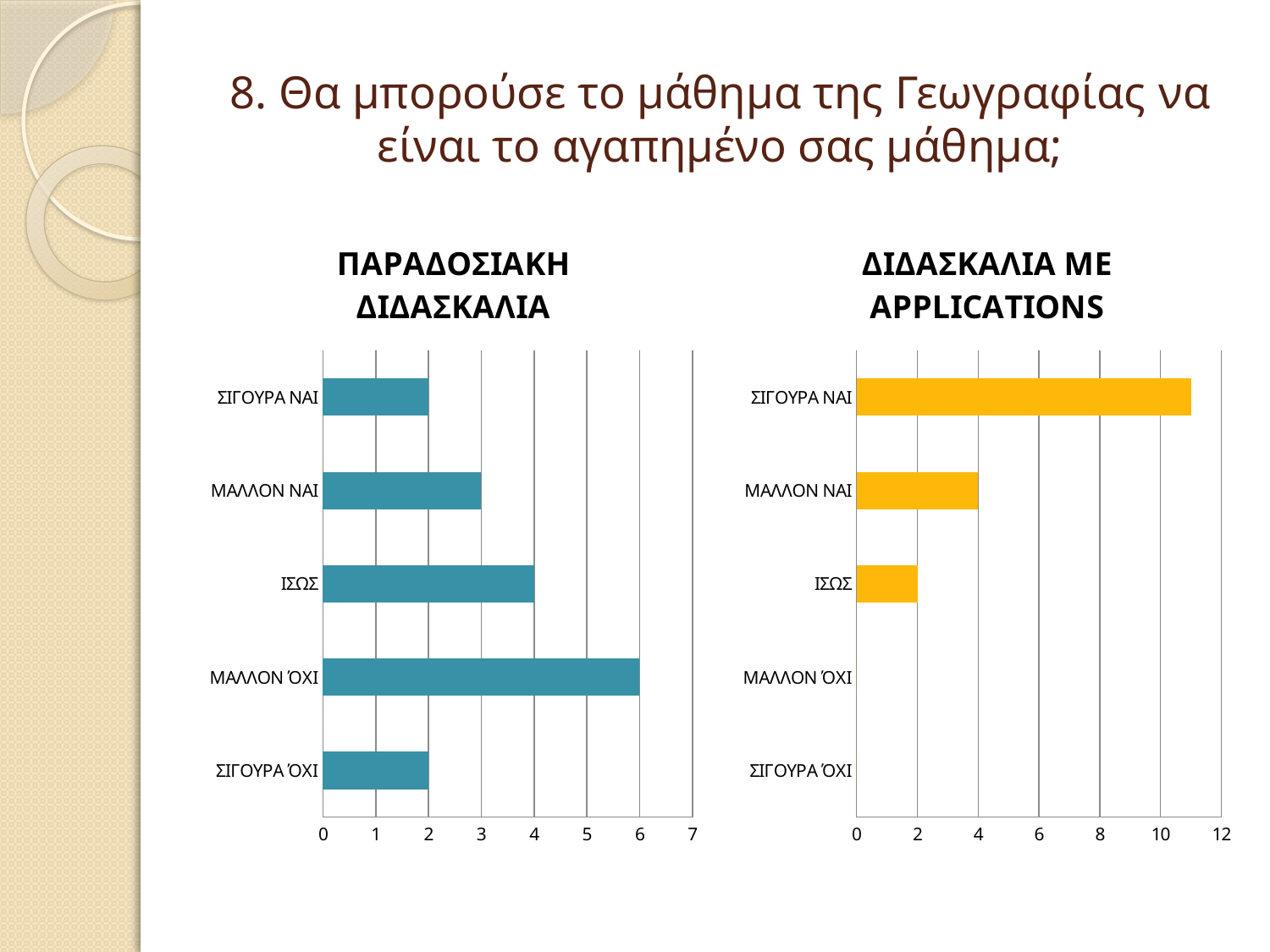
What kind of chart is the ΔΙΔΑΣΚΑΛΙΑ ΜΕ APPLICATIONS chart? Bar chart In the ΠΑΡΑΔΟΣΙΑΚΗ ΔΙΔΑΣΚΑΛΙΑ chart, what is the difference between ΜΑΛΛΟΝ ΌΧΙ and ΙΣΩΣ? 2 In the ΠΑΡΑΔΟΣΙΑΚΗ ΔΙΔΑΣΚΑΛΙΑ chart, which category has the highest value? ΜΑΛΛΟΝ ΌΧΙ In the ΠΑΡΑΔΟΣΙΑΚΗ ΔΙΔΑΣΚΑΛΙΑ chart, which is larger: ΙΣΩΣ or ΜΑΛΛΟΝ ΝΑΙ? ΙΣΩΣ How many categories are shown in the ΠΑΡΑΔΟΣΙΑΚΗ ΔΙΔΑΣΚΑΛΙΑ chart? 5 In the ΔΙΔΑΣΚΑΛΙΑ ΜΕ APPLICATIONS chart, is the value for ΣΙΓΟΥΡΑ ΝΑΙ greater or less than 10? greater In the ΔΙΔΑΣΚΑΛΙΑ ΜΕ APPLICATIONS chart, what is the value for ΜΑΛΛΟΝ ΝΑΙ? 4 What colour are the bars in the ΔΙΔΑΣΚΑΛΙΑ ΜΕ APPLICATIONS chart? Yellow In the ΔΙΔΑΣΚΑΛΙΑ ΜΕ APPLICATIONS chart, what is the value for ΙΣΩΣ? 2 In the ΔΙΔΑΣΚΑΛΙΑ ΜΕ APPLICATIONS chart, which category has the highest value? ΣΙΓΟΥΡΑ ΝΑΙ In the ΠΑΡΑΔΟΣΙΑΚΗ ΔΙΔΑΣΚΑΛΙΑ chart, what is the value for ΜΑΛΛΟΝ ΌΧΙ? 6 In the ΠΑΡΑΔΟΣΙΑΚΗ ΔΙΔΑΣΚΑΛΙΑ chart, what is the value for ΙΣΩΣ? 4